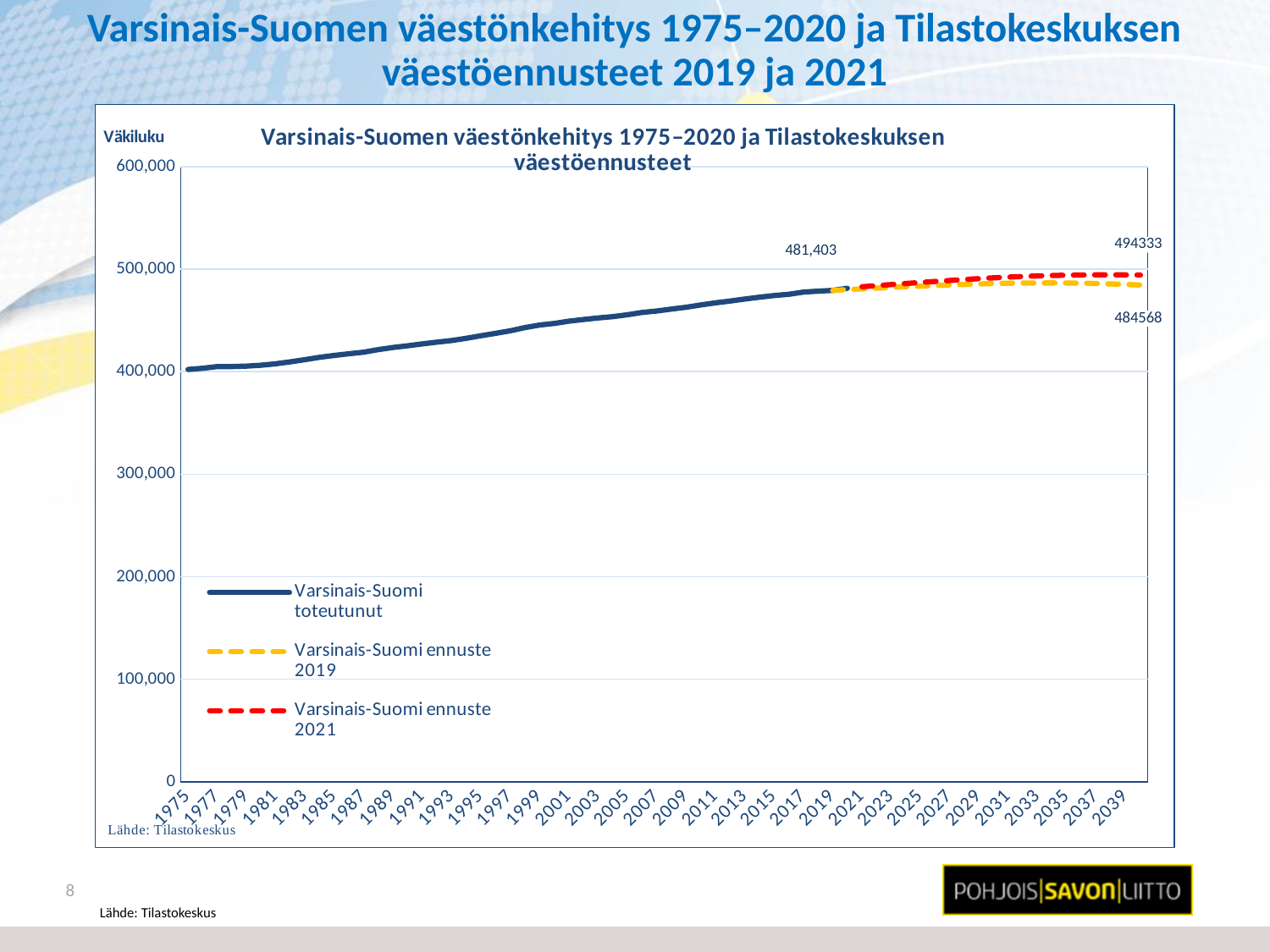
Which forecast series ends at a higher value, Varsinais-Suomi ennuste 2019 or Varsinais-Suomi ennuste 2021? Varsinais-Suomi ennuste 2021 Is the value of the Varsinais-Suomi toteutunut series in 2001 greater or less than 400,000? greater What kind of chart is shown on the slide? line chart What is the label on the vertical axis of the chart? Väkiluku How many series does the legend list? 3 What is the labelled end value of the Varsinais-Suomi ennuste 2019 series? 484568 What source is cited below the chart? Lähde: Tilastokeskus Does the Varsinais-Suomi toteutunut series rise or fall from 1975 to 2019? rise What is the labelled value at the end of the Varsinais-Suomi toteutunut series? 481,403 Is the value of the Varsinais-Suomi toteutunut series in 1985 greater or less than 500,000? less What is the difference between the end values of the ennuste 2021 series (494333) and the ennuste 2019 series (484568)? 9765 What is the labelled end value of the Varsinais-Suomi ennuste 2021 series? 494333